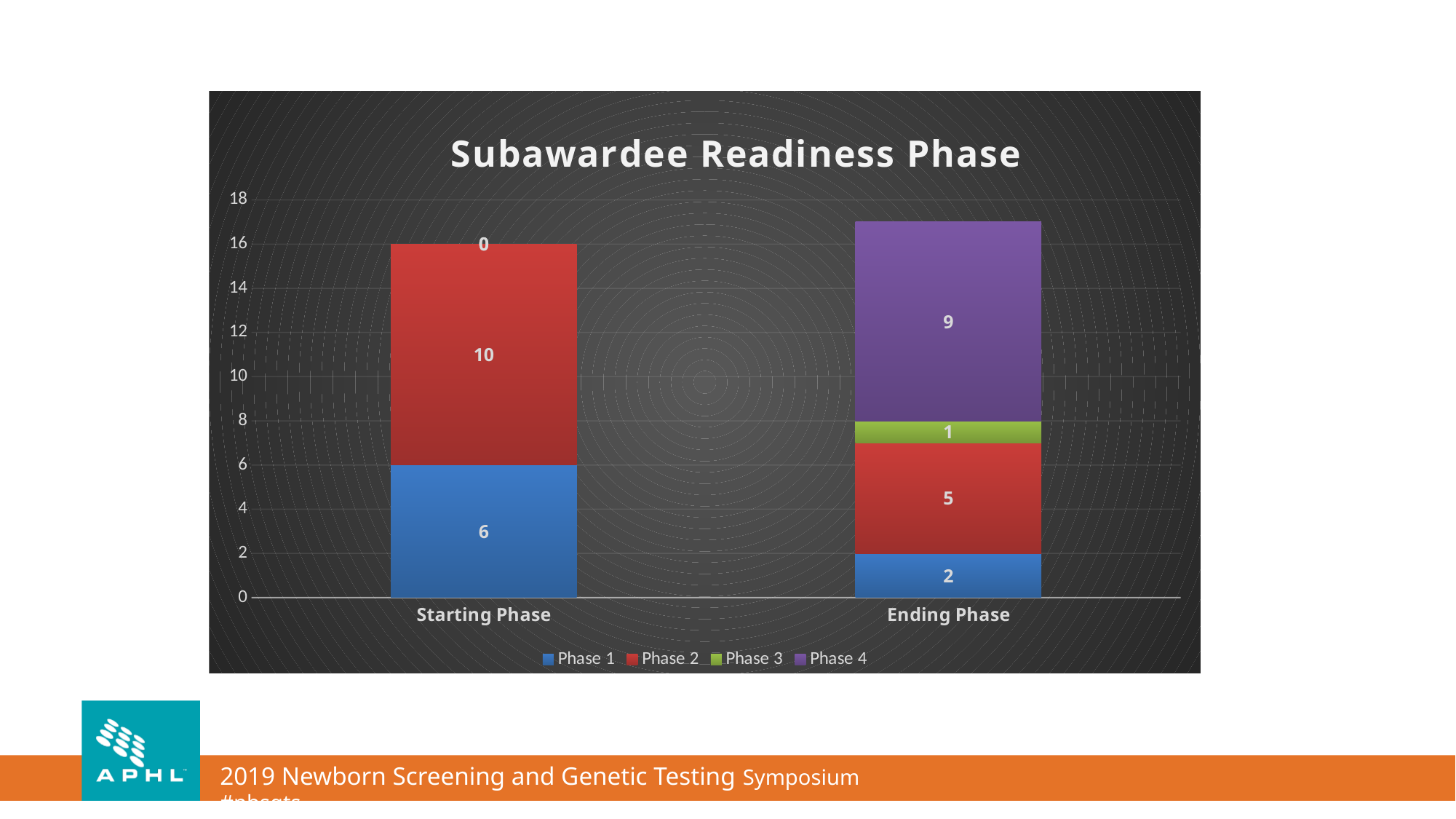
What is the Phase 2 value for Starting Phase? 10 What is the Phase 1 value for Starting Phase? 6 What is the difference between the Phase 2 value for Starting Phase and the Phase 2 value for Ending Phase? 5 What is the total of the Ending Phase stacked bar? 17 What is the Phase 3 value for Ending Phase? 1 What is the Phase 4 value for Ending Phase? 9 Which is larger, the Phase 1 value for Starting Phase or the Phase 1 value for Ending Phase? Starting Phase What type of chart is shown on the slide? Stacked bar chart What is the title of the chart? Subawardee Readiness Phase How many series does the legend list? 4 How many categories are shown on the x axis? 2 What is the total of the Starting Phase stacked bar? 16